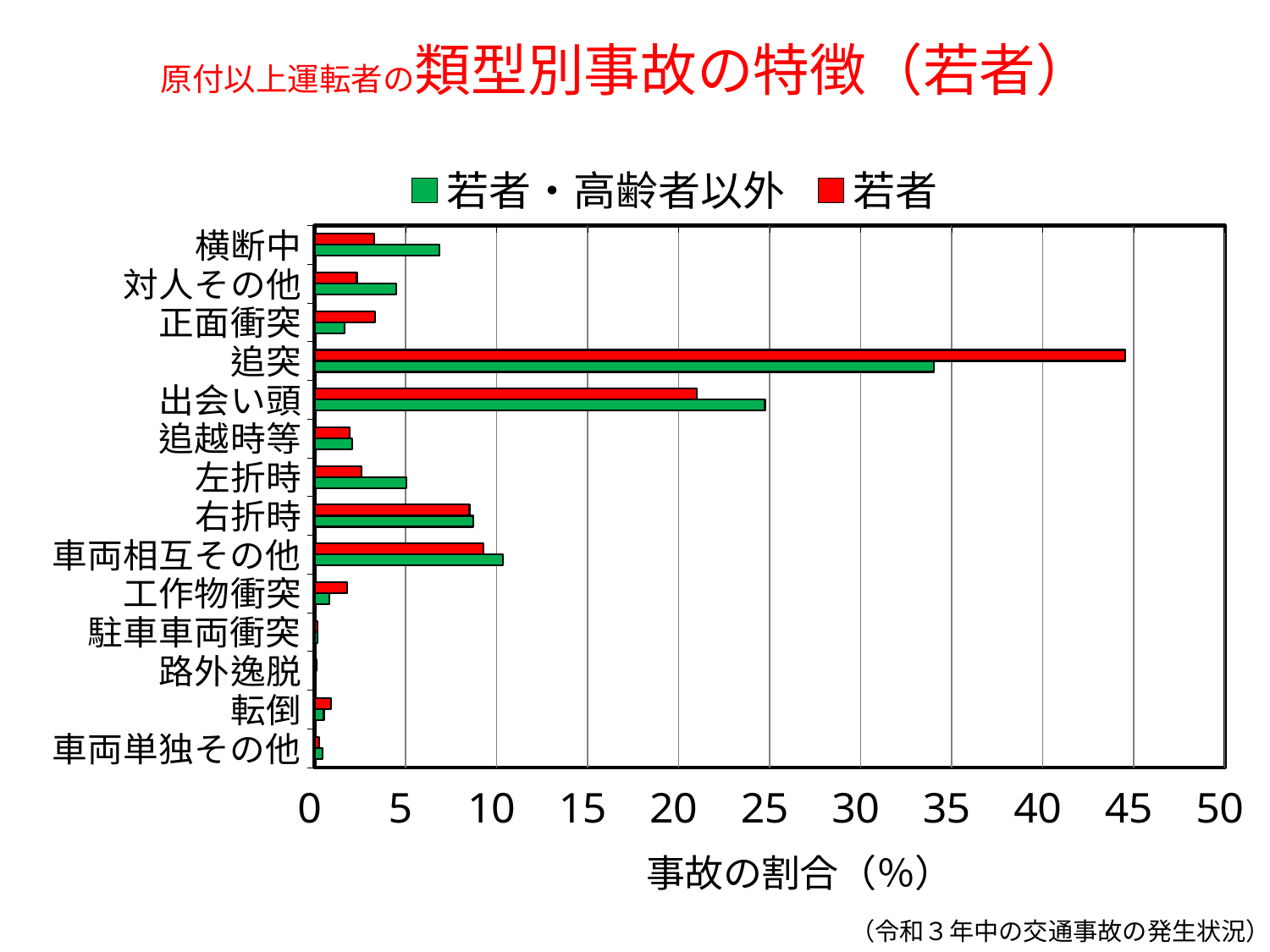
For 出会い頭, which series has the larger value, 若者 or 若者・高齢者以外? 若者・高齢者以外 Which category has the highest value for the 若者 series? 追突 Is the 若者 value for 追突 greater or less than 40? greater How many series does the legend list? 2 How many accident-type categories are plotted on the y axis? 14 What kind of chart is shown on the slide? bar chart For 追突, which series has the larger value, 若者 or 若者・高齢者以外? 若者 Is the 若者・高齢者以外 value for 横断中 greater or less than 5? greater For 左折時, which series has the larger value, 若者 or 若者・高齢者以外? 若者・高齢者以外 Is the 若者・高齢者以外 value for 追突 greater or less than 30? greater What is the label of the x axis? 事故の割合（%） Which category has the highest value for the 若者・高齢者以外 series? 追突